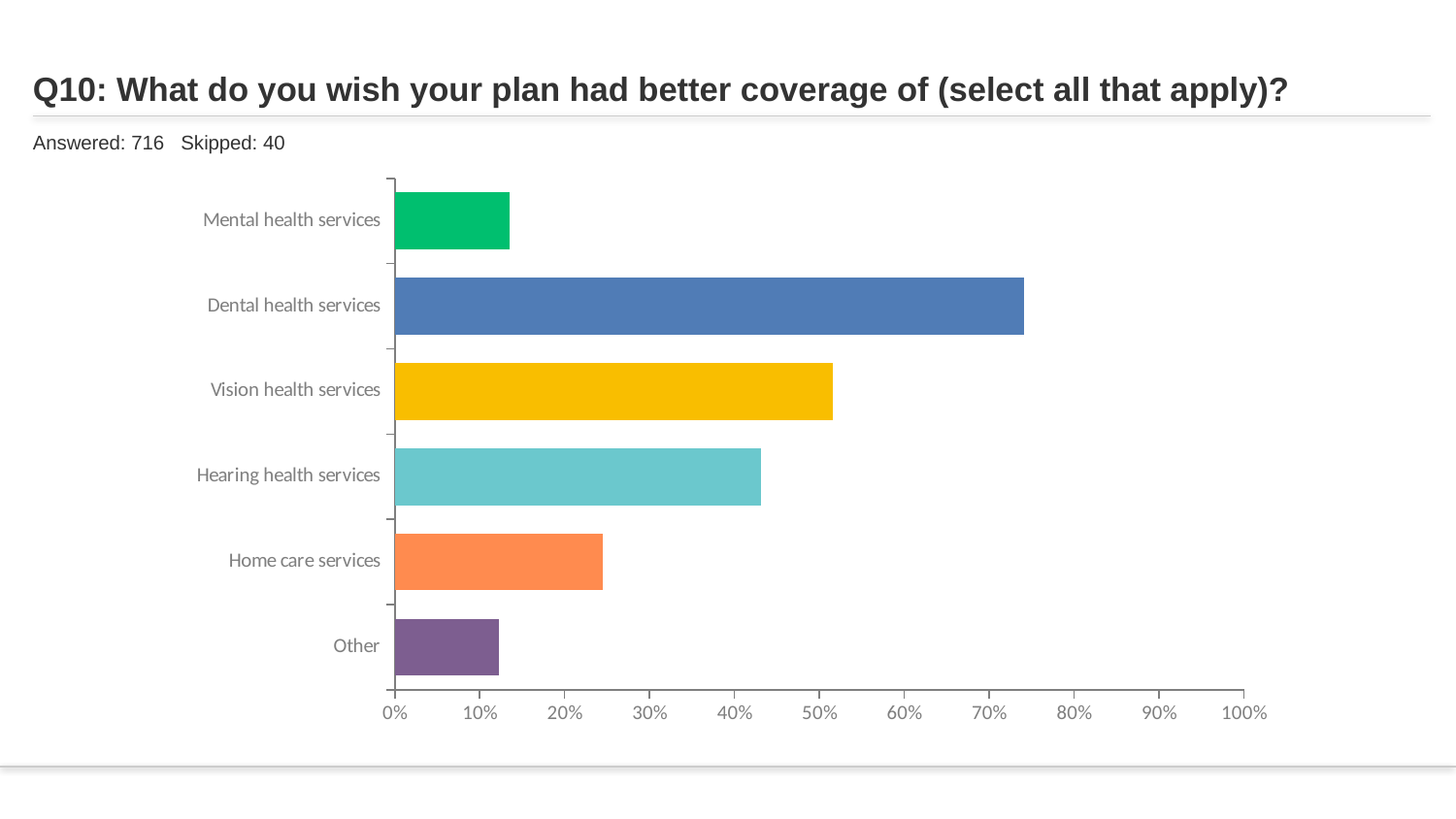
Which is larger, the value for Home care services or Mental health services? Home care services Which is larger, the value for Vision health services or Hearing health services? Vision health services How many respondents skipped this question according to the slide? 40 Is the value for Home care services greater or less than 20%? greater Is the value for Hearing health services greater or less than 50%? less What type of chart is shown on the slide? Bar chart Is the value for Mental health services greater or less than 20%? less Which category has the highest value in the chart? Dental health services How many respondents answered this question according to the slide? 716 How many categories are shown in the chart? 6